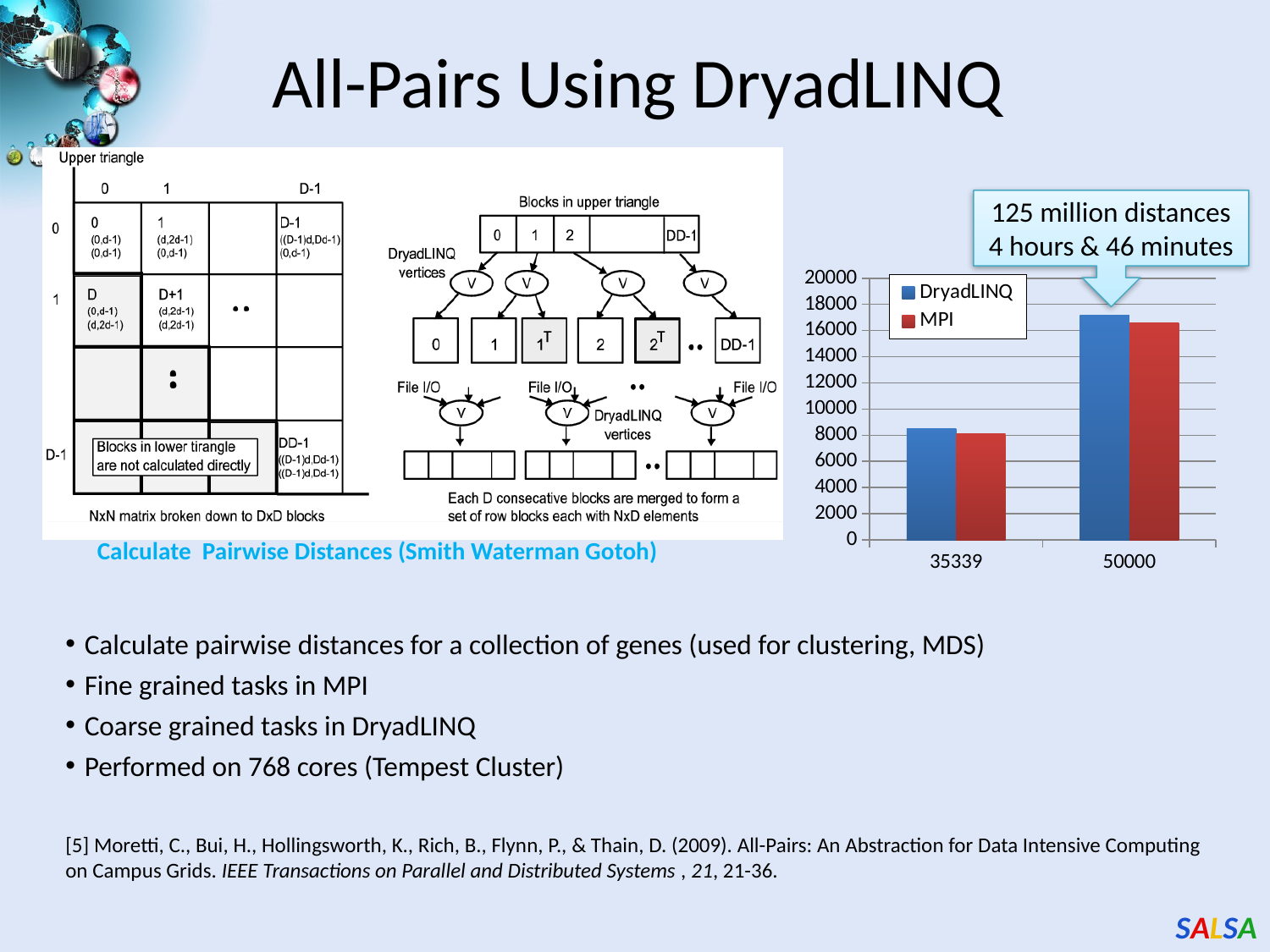
Is the MPI value for 50000 greater or less than 18000? less Is the DryadLINQ value for 50000 greater or less than 16000? greater How many series does the legend of the bar chart list? 2 Is the MPI value for 35339 greater or less than 10000? less Which two series are listed in the legend of the bar chart? DryadLINQ and MPI For the 50000 category, which series has the larger value, DryadLINQ or MPI? DryadLINQ Which bar in the chart is the tallest? DryadLINQ at 50000 What kind of chart is shown on the right of the slide? bar chart How many categories are shown on the x axis of the bar chart? 2 What colour are the MPI bars in the chart? red Do the values for both series rise or fall from 35339 to 50000? rise